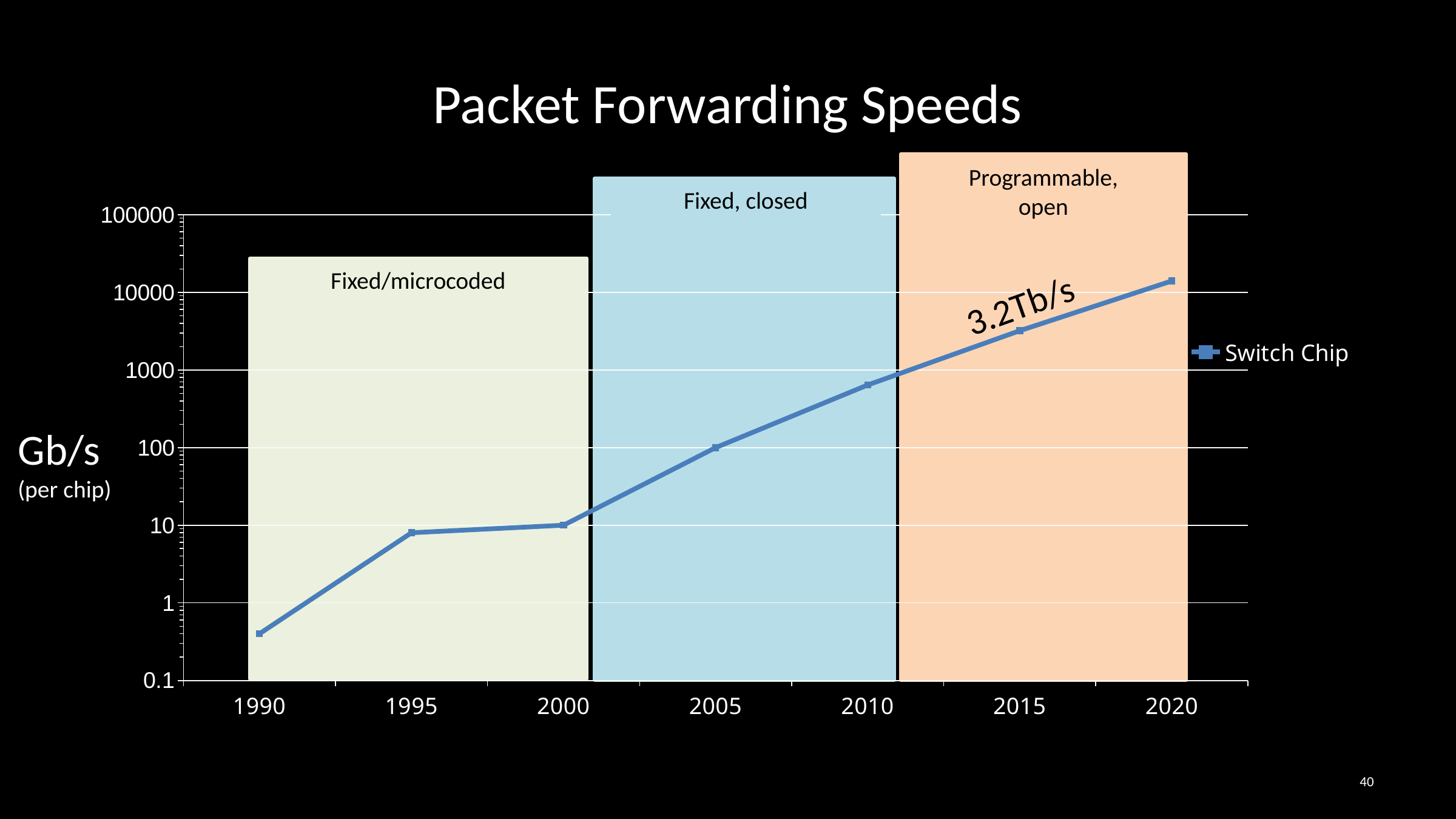
Is the Switch Chip value for 2020 greater or less than 10000? greater How many series does the legend list? 1 What is the Switch Chip value for 2000 in Gb/s? 10 How many data points are plotted on the Switch Chip line? 7 What is the Switch Chip value for 2005 in Gb/s? 100 Is the Switch Chip value for 1990 greater or less than 1? less Which year has the highest Switch Chip value? 2020 Is the Switch Chip value for 2010 greater or less than 1000? less What speed is annotated on the chart for 2015? 3.2Tb/s Which year has the lowest Switch Chip value? 1990 What kind of chart is shown on the slide? line chart Do the Switch Chip values rise or fall from 1990 to 2020? rise